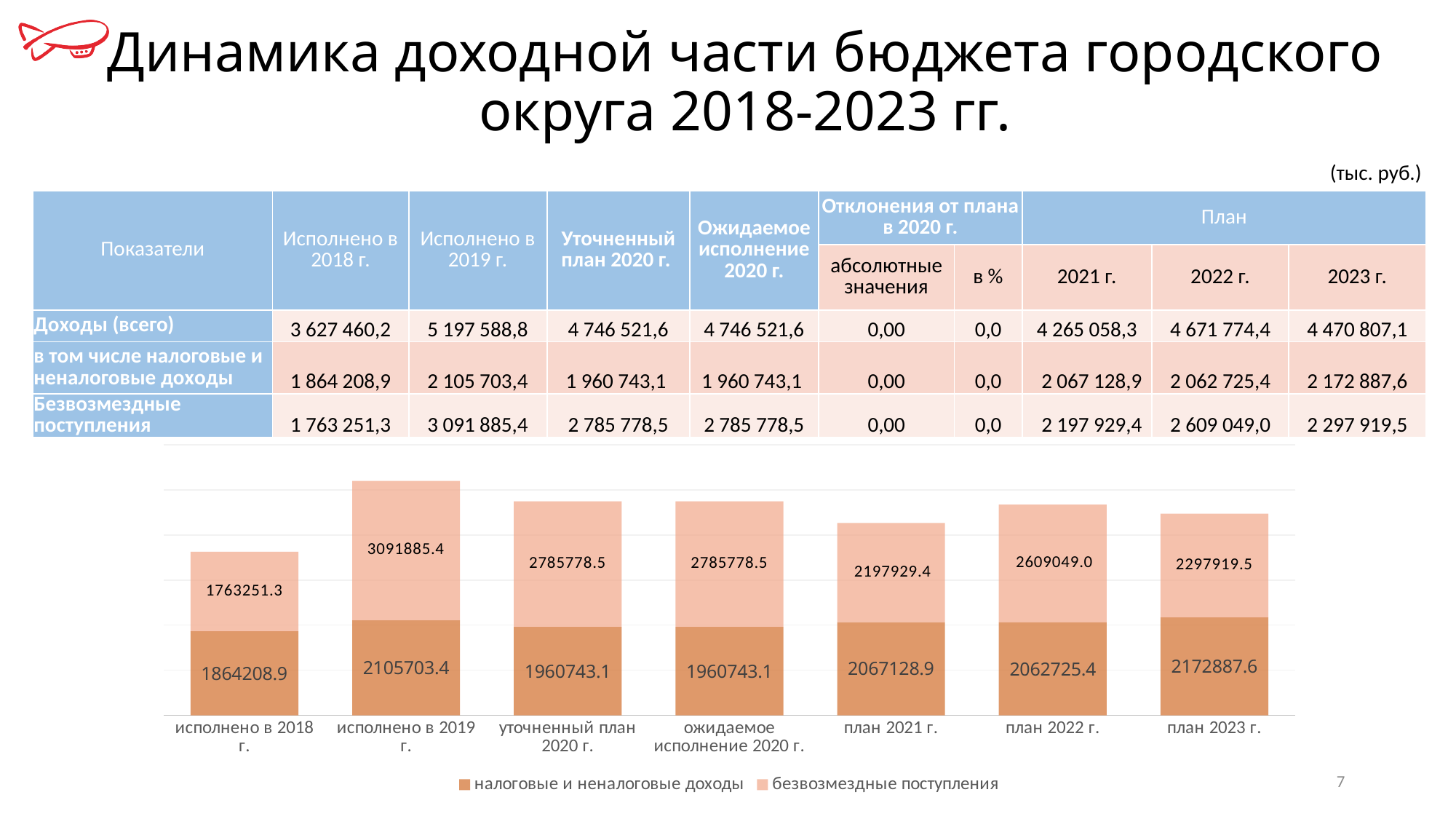
What is the value of налоговые и неналоговые доходы for план 2021 г. in the chart? 2067128.9 Which category has the highest value of безвозмездные поступления in the chart? исполнено в 2019 г. What is the difference between безвозмездные поступления for исполнено в 2019 г. and исполнено в 2018 г. in the chart? 1328634.1 How many categories are shown along the x axis of the chart? 7 Which is larger in the chart: налоговые и неналоговые доходы for план 2023 г. or for исполнено в 2019 г.? план 2023 г. What is the value of безвозмездные поступления for план 2022 г. in the chart? 2609049.0 What type of chart is shown on the slide? stacked bar chart Which category has the lowest value of налоговые и неналоговые доходы in the chart? исполнено в 2018 г. How many series does the chart legend list? 2 What is the value of безвозмездные поступления for исполнено в 2019 г. in the chart? 3091885.4 What is the total of the stacked bar for исполнено в 2018 г. in the chart? 3627460.2 Which series in the chart is shown in the darker orange colour? налоговые и неналоговые доходы